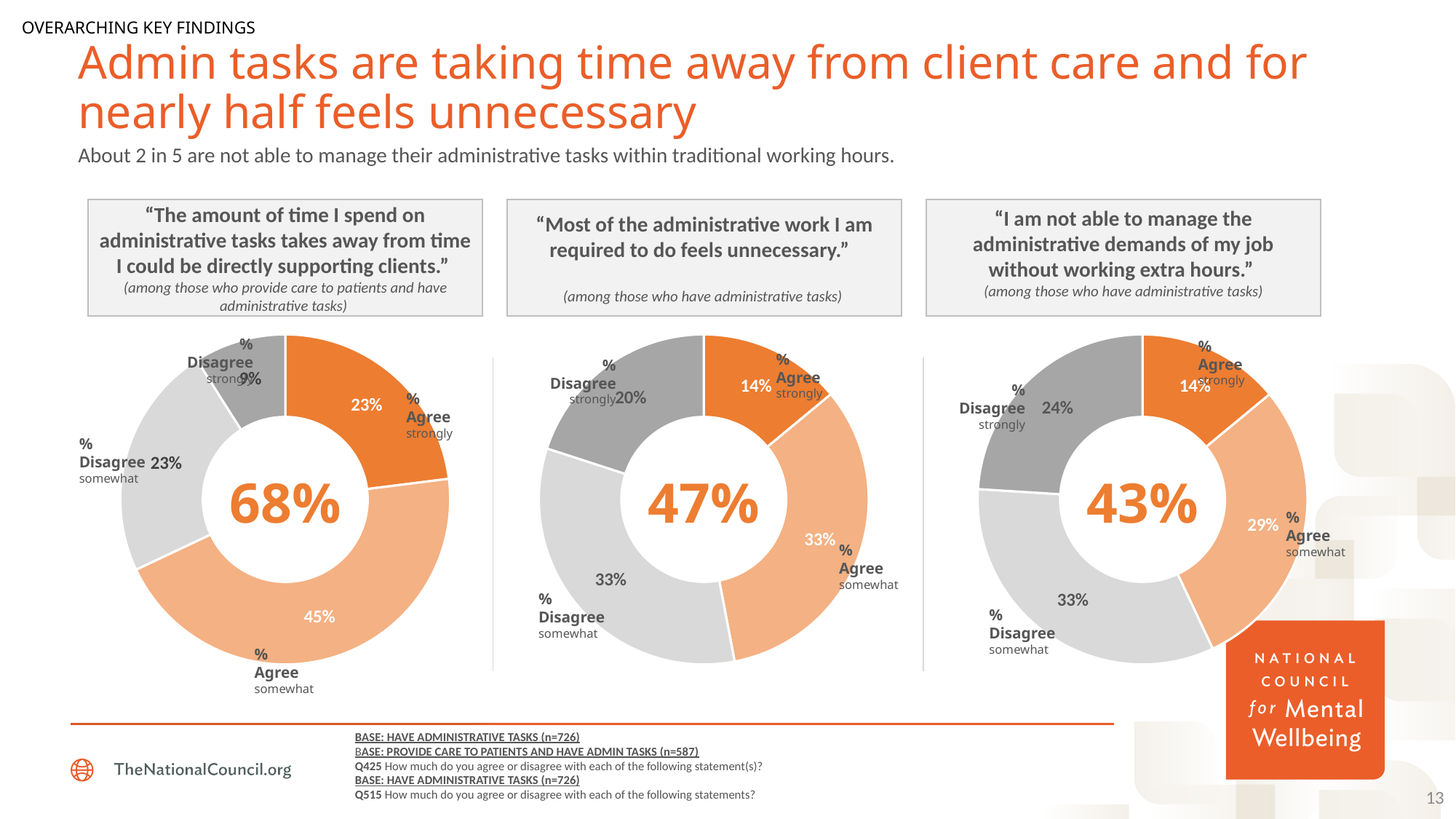
In the left chart ("The amount of time I spend on administrative tasks..."), what percentage disagree strongly? 9% In the right chart ("I am not able to manage the administrative demands of my job without working extra hours"), which response category has the smallest share? Agree strongly In the right chart ("I am not able to manage the administrative demands..."), which is larger: the disagree somewhat share or the disagree strongly share? Disagree somewhat In the middle chart ("Most of the administrative work I am required to do feels unnecessary"), what percentage disagree strongly? 20% In the left chart ("The amount of time I spend on administrative tasks..."), which response category has the largest share? Agree somewhat How many response categories does each donut chart on the slide show? 4 In the middle chart ("Most of the administrative work I am required to do feels unnecessary"), what is the difference between the agree somewhat and disagree strongly shares? 13% In the left chart ("The amount of time I spend on administrative tasks..."), what is the total percentage shown in the centre of the donut? 68% In the middle chart ("Most of the administrative work I am required to do feels unnecessary"), what percentage agree strongly? 14% In the left chart ("The amount of time I spend on administrative tasks takes away from time I could be directly supporting clients"), what percentage agree somewhat? 45% What type of chart is used for the three charts on the slide? Donut (pie) chart In the right chart ("I am not able to manage the administrative demands of my job without working extra hours"), what percentage agree somewhat? 29%